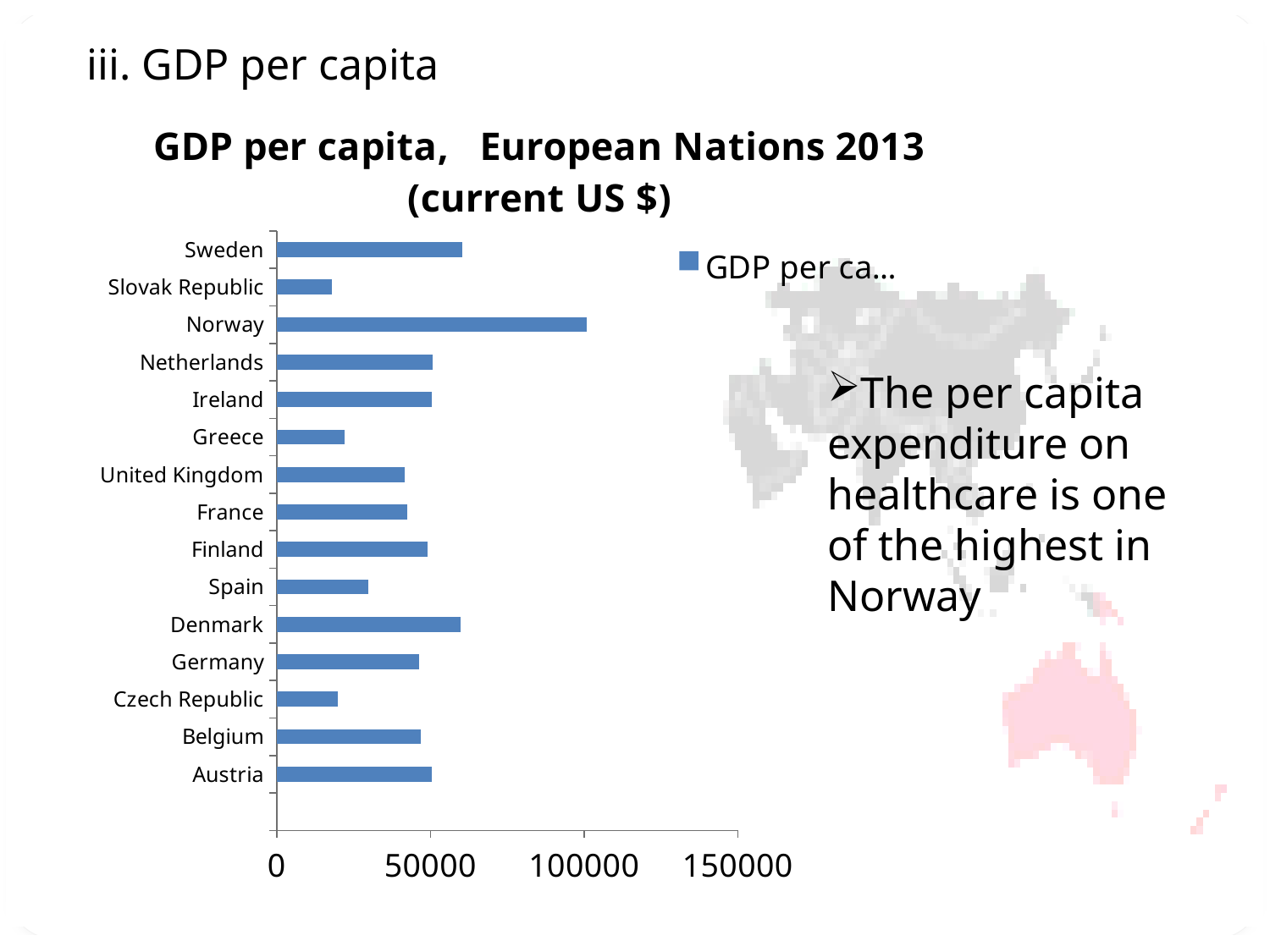
Which has the larger GDP per capita, Norway or Sweden? Norway Is the value for Spain greater or less than 50000? less What kind of chart is shown on the slide? bar chart Which country has the highest GDP per capita in the chart? Norway Is the value for Slovak Republic greater or less than 50000? less How many series does the legend list? 1 What is the title of the chart? GDP per capita, European Nations 2013 (current US $) Is the value for Greece greater or less than 50000? less How many countries are plotted in the chart? 15 Which has the larger GDP per capita, Greece or Germany? Germany